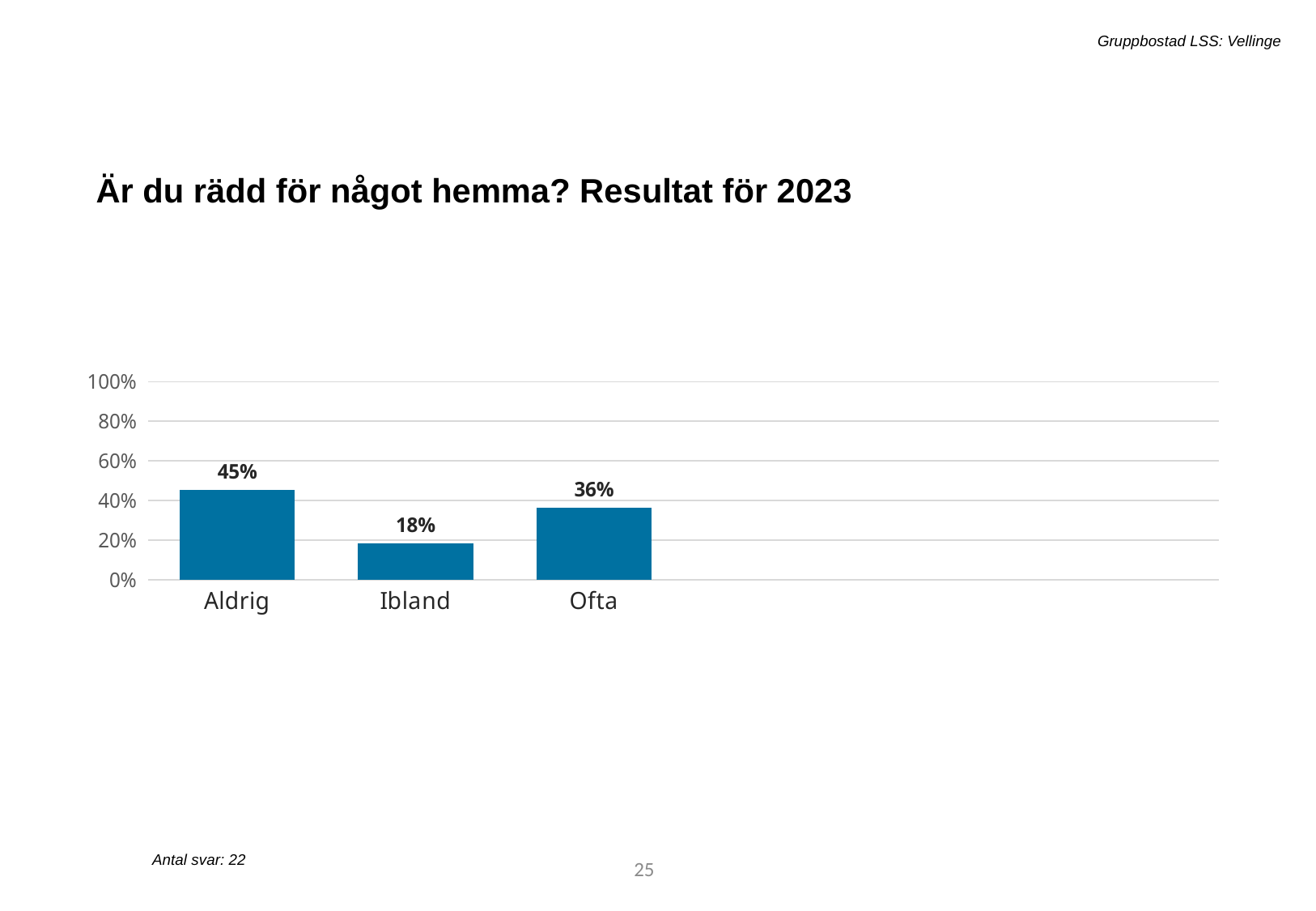
What is the difference between the values for Aldrig and Ibland? 27% What is the value for Aldrig? 45% What is the difference between the values for Aldrig and Ofta? 9% How many categories are shown on the x axis? 3 What kind of chart is shown on the slide? bar chart What is the value for Ibland? 18% What is the value for Ofta? 36% Which category has the lowest value? Ibland Which is larger, the value for Ofta or the value for Ibland? Ofta What is the title of the slide? Är du rädd för något hemma? Resultat för 2023 Which category has the highest value? Aldrig Is the value for Aldrig greater or less than 40%? greater